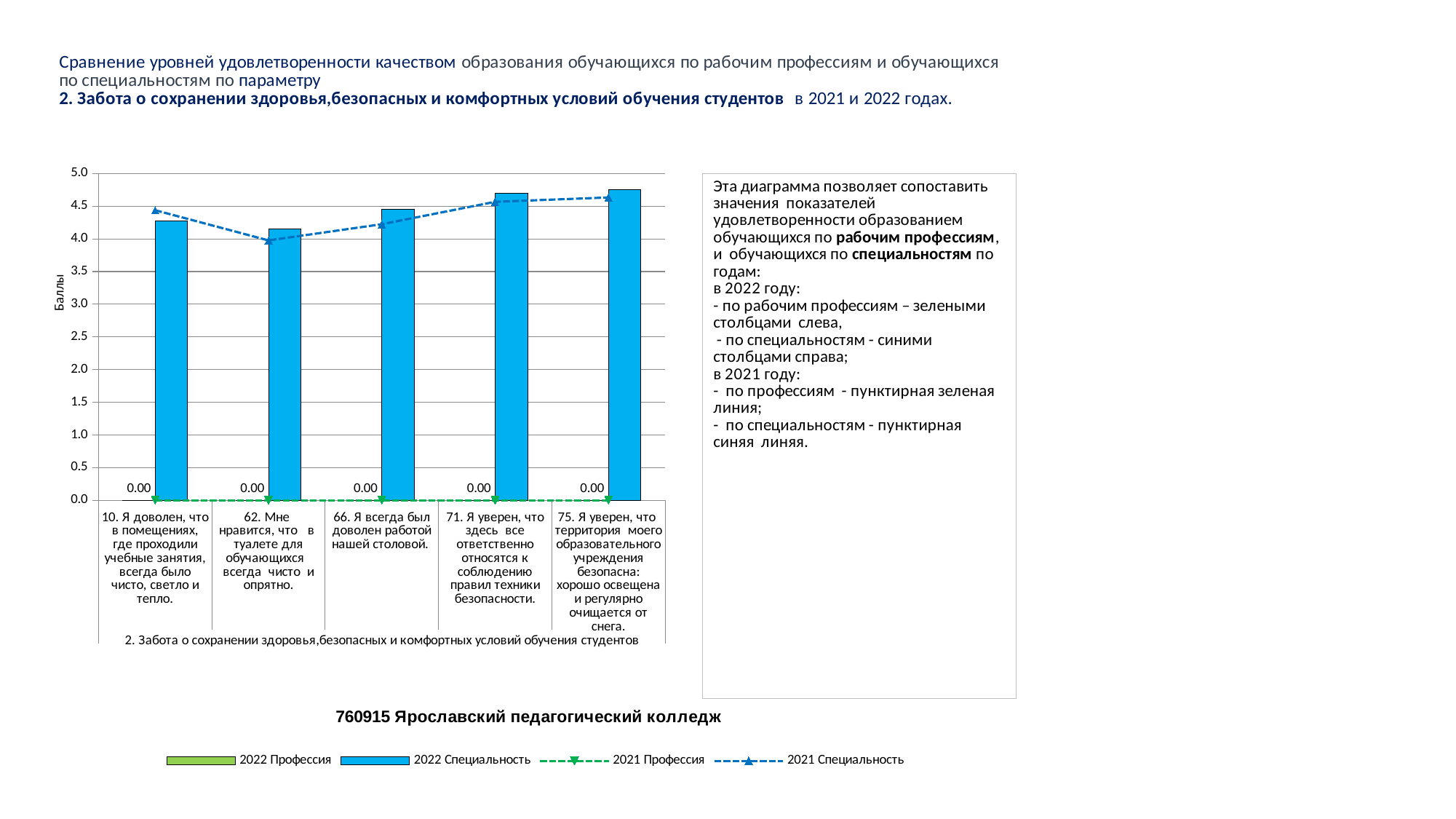
How many series does the legend list? 4 What value is printed for the 2022 Профессия series for statement 10? 0.00 Is the 2022 Специальность value for statement 10 greater or less than 4.5? less Which statement has the lowest 2022 Специальность bar? 62. Мне нравится, что в туалете для обучающихся всегда чисто и опрятно. Is the 2022 Специальность value for statement 62 greater or less than 4.0? greater What kind of chart is shown on the slide? Bar chart with line series Is the 2022 Специальность value for statement 75 greater or less than 4.5? greater What value is printed for the 2022 Профессия series for statement 75? 0.00 How many categories (survey statements) are shown on the x axis? 5 Does the 2021 Специальность line rise or fall from statement 62 to statement 75? Rises Which is larger for 2022 Специальность: the bar for statement 66 or the bar for statement 62? Statement 66 What is the label on the vertical axis? Баллы